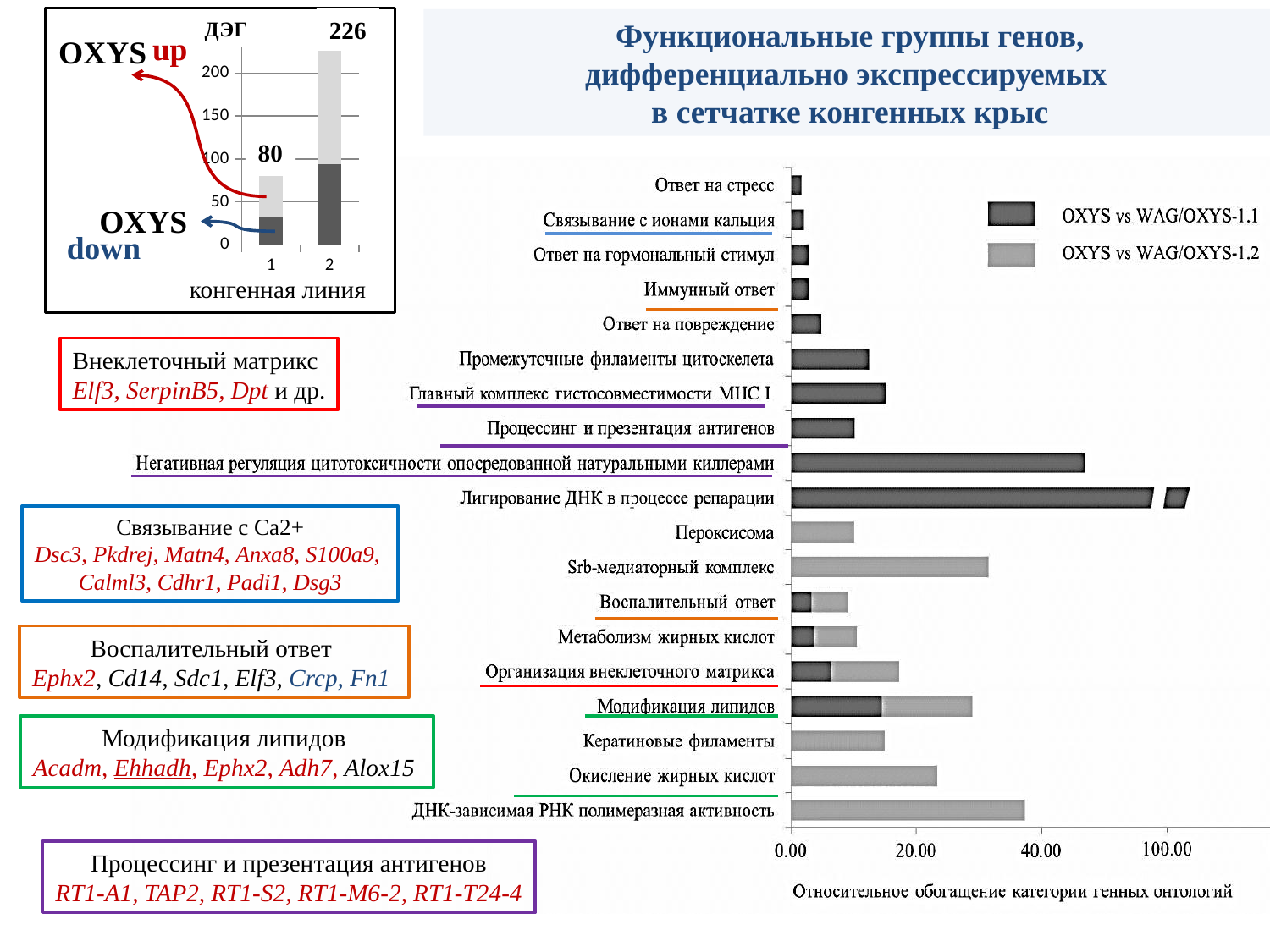
In the small chart at the top left (ДЭГ), what is the difference between the totals for congenic line 2 and congenic line 1? 146 In the small chart at the top left (ДЭГ), what is the total value shown for congenic line 2? 226 In the large chart on the right, which is larger: the value for Srb-медиаторный комплекс or the value for Пероксисома? Srb-медиаторный комплекс In the large chart on the right, is the value for ДНК-зависимая РНК полимеразная активность greater or less than 20.00? greater In the large chart on the right, how many series does the legend list? 2 In the large chart on the right, is the value for Пероксисома greater or less than 20.00? less In the small chart at the top left (ДЭГ), which congenic line has the higher total? 2 In the small chart at the top left (ДЭГ), what is the total value shown for congenic line 1? 80 What kind of chart is the small chart at the top left (ДЭГ)? Stacked bar chart In the large chart on the right, how many categories are plotted? 19 In the large chart on the right, which category has the longest bar? Лигирование ДНК в процессе репарации